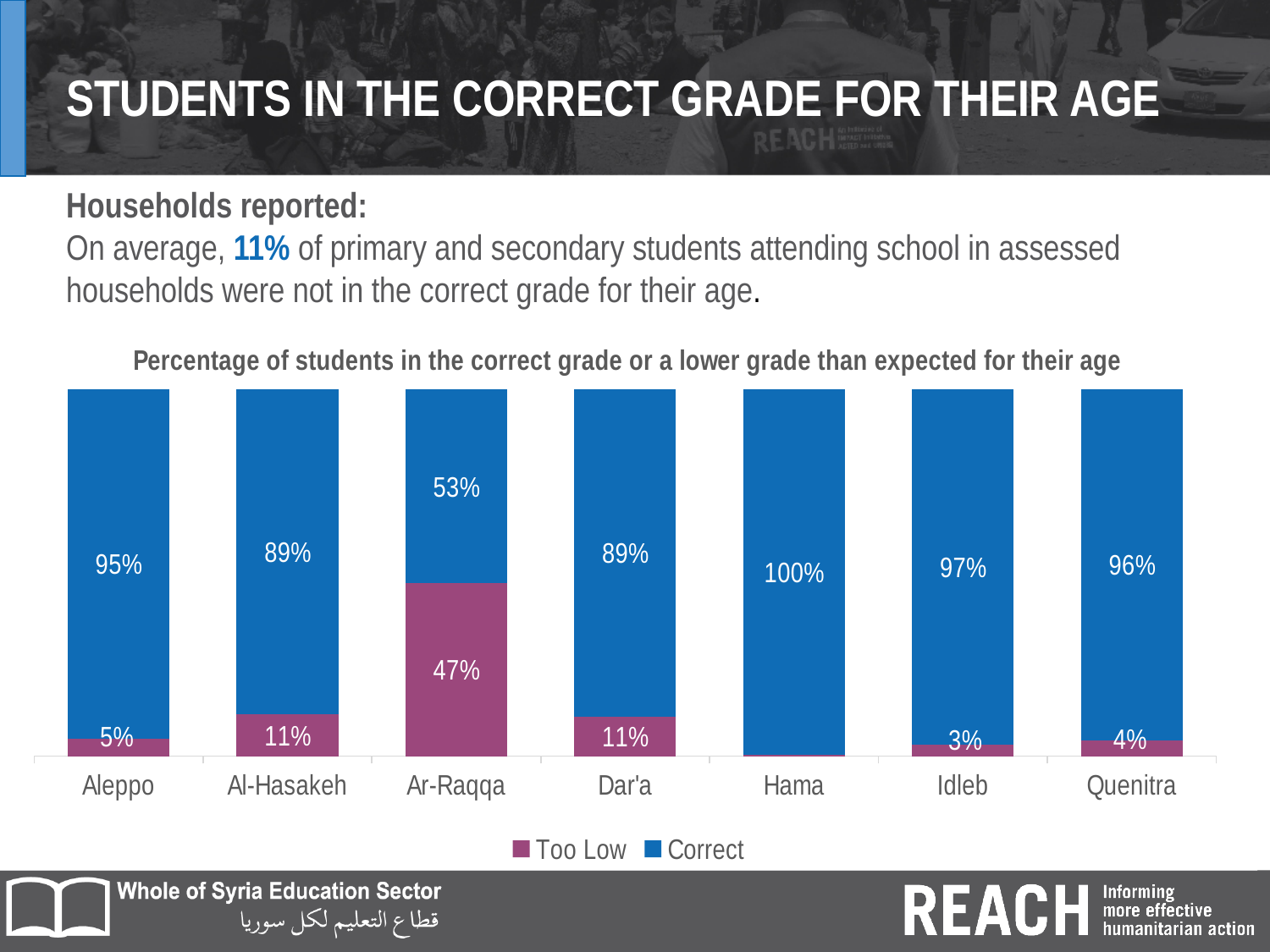
Which colour represents the 'Too Low' series in the legend? Purple What is the difference between the 'Correct' percentages for Aleppo and Al-Hasakeh? 6% What percentage of students in Ar-Raqqa are in the correct grade for their age? 53% Which governorate has the highest 'Too Low' percentage? Ar-Raqqa Is the 'Too Low' value larger for Aleppo or for Quenitra? Aleppo How many governorates are shown on the x axis? 7 What is the 'Too Low' value for Al-Hasakeh? 11% How many series does the legend list? 2 What kind of chart is shown on the slide? Stacked bar chart Which governorate has the highest 'Correct' percentage? Hama Which governorate has the lowest 'Correct' percentage? Ar-Raqqa What is the 'Correct' value for Idleb? 97%